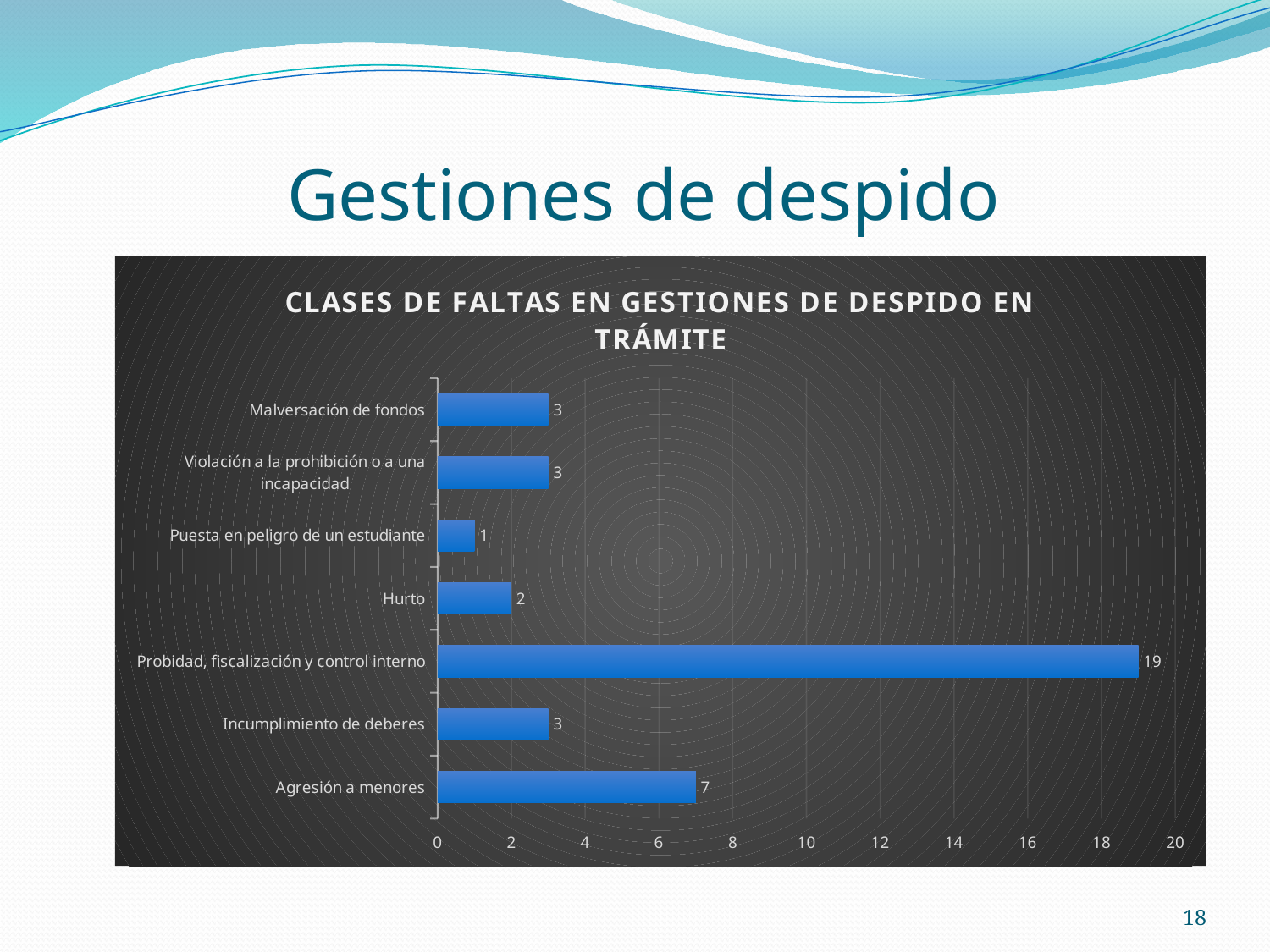
What is the value for Puesta en peligro de un estudiante? 1 Is the value for Probidad, fiscalización y control interno greater or less than 10? greater What is the value for Probidad, fiscalización y control interno? 19 How many categories are shown in the chart? 7 What is the title of the chart? CLASES DE FALTAS EN GESTIONES DE DESPIDO EN TRÁMITE Which category has the highest value? Probidad, fiscalización y control interno What is the value for Agresión a menores? 7 Which category has the lowest value? Puesta en peligro de un estudiante What kind of chart is shown on the slide? Bar chart Which is larger, the value for Agresión a menores or the value for Incumplimiento de deberes? Agresión a menores What is the difference between the values for Probidad, fiscalización y control interno and Agresión a menores? 12 What is the value for Hurto? 2